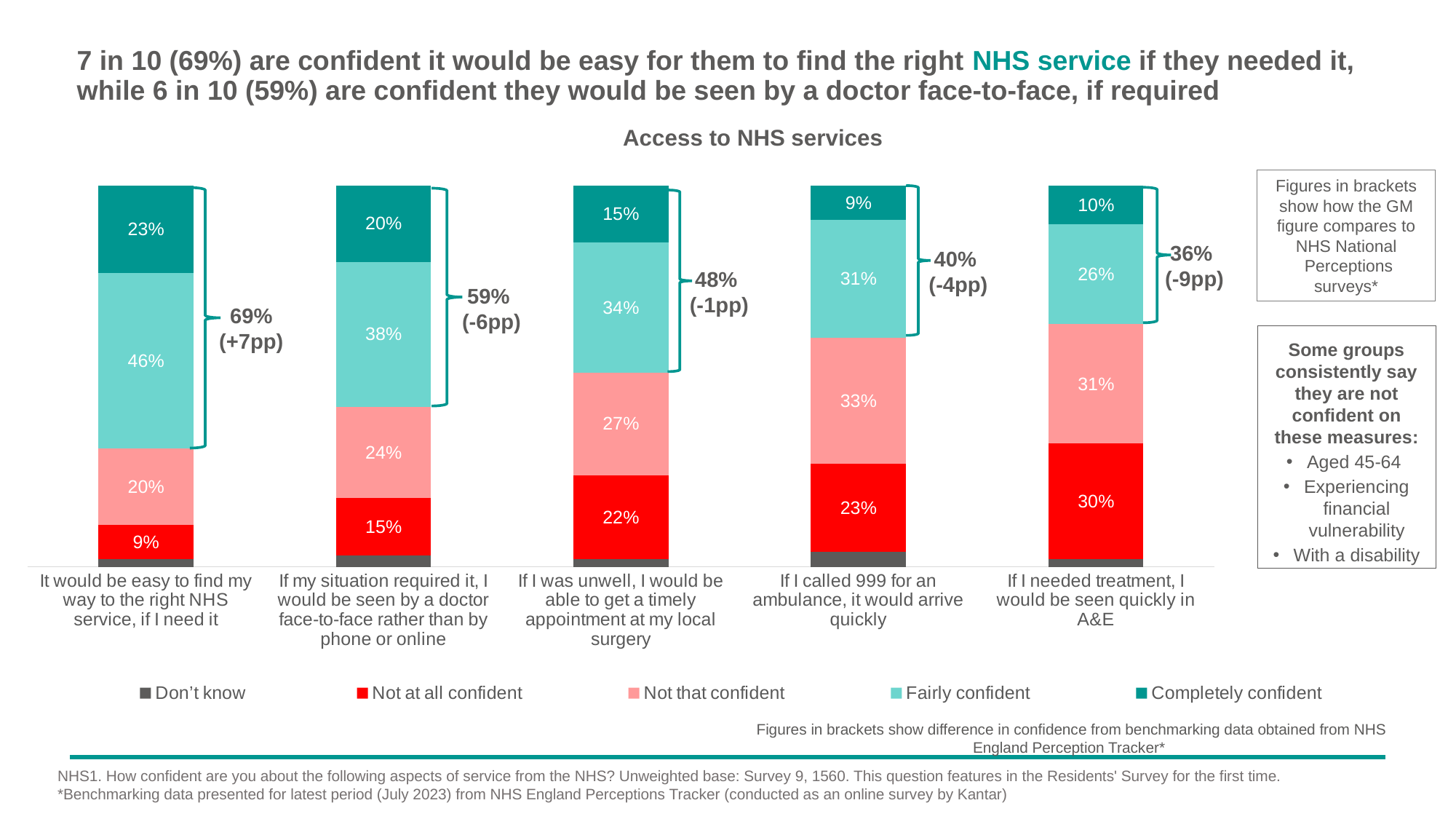
What is the difference from the NHS national benchmark shown in brackets for the face-to-face doctor statement? -6pp How many series does the legend list? 5 Which statement has the lowest 'Completely confident' percentage? If I called 999 for an ambulance, it would arrive quickly Which statement has the highest 'Fairly confident' percentage? It would be easy to find my way to the right NHS service, if I need it What is the combined confident figure shown for 'If I called 999 for an ambulance, it would arrive quickly'? 40% How many categories (statements) are plotted on the chart? 5 Which is larger: the 'Not at all confident' share for the timely appointment statement or for the face-to-face doctor statement? Timely appointment at my local surgery (22%) What percentage are 'Not at all confident' that they would be seen quickly in A&E if they needed treatment? 30% What is the difference between the 'Not that confident' percentages for the A&E statement and the 'easy to find my way' statement? 11 percentage points What percentage are 'Completely confident' that it would be easy to find their way to the right NHS service? 23% What is the title of the chart? Access to NHS services What kind of chart is shown on the slide? Stacked bar chart